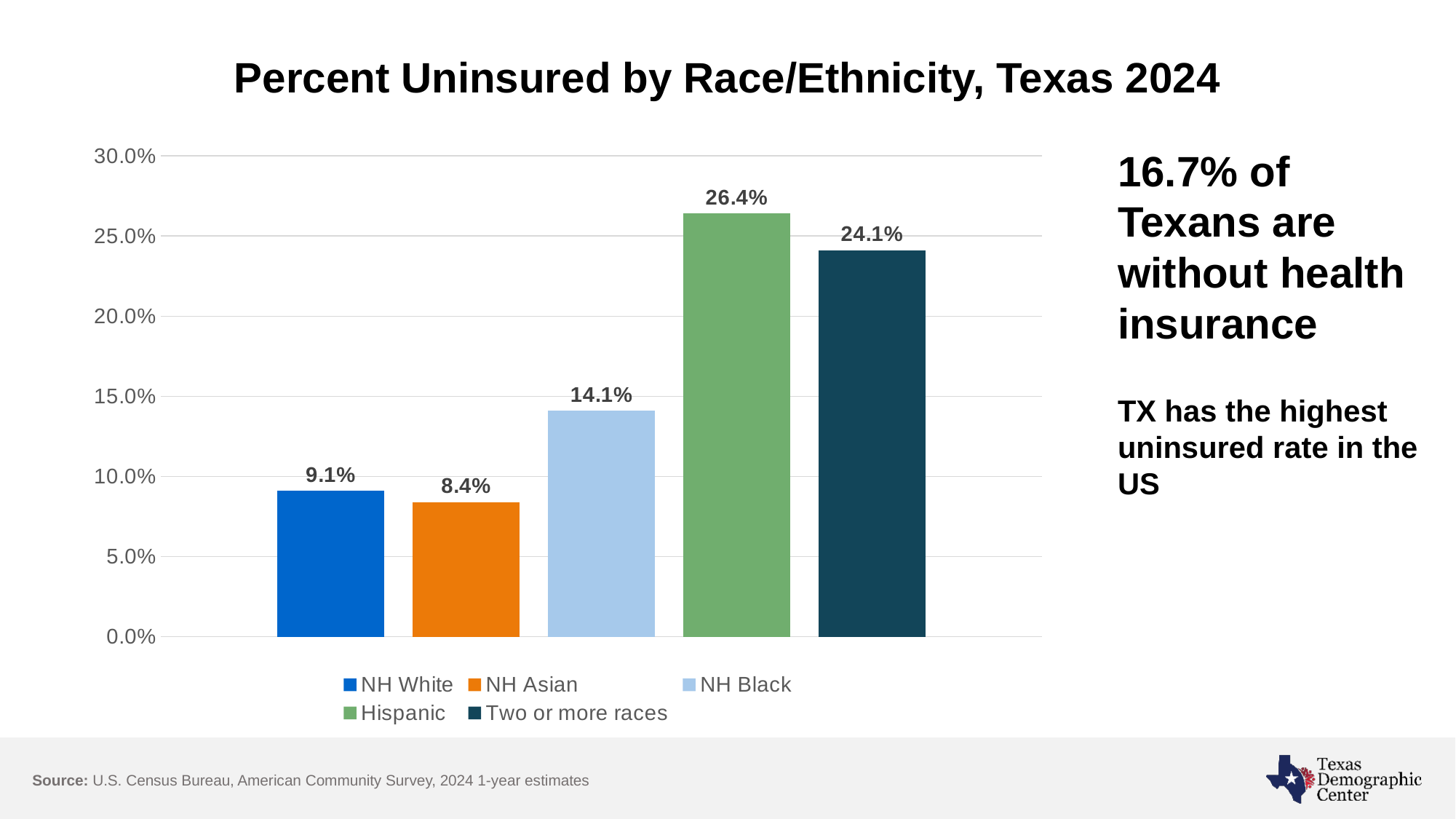
What is the difference in percent uninsured between NH White and NH Asian? 0.7% What kind of chart is shown on the slide? bar chart What is the percent uninsured for Two or more races? 24.1% What is the difference in percent uninsured between Hispanic and NH Black? 12.3% Which group has the highest percent uninsured? Hispanic How many race/ethnicity groups are shown in the chart? 5 Which has a higher percent uninsured, NH Black or Two or more races? Two or more races What is the title of the chart? Percent Uninsured by Race/Ethnicity, Texas 2024 Which group has the lowest percent uninsured? NH Asian Is the value for NH Black greater or less than 15.0%? less What is the percent uninsured for NH White? 9.1% What is the percent uninsured for Hispanic? 26.4%